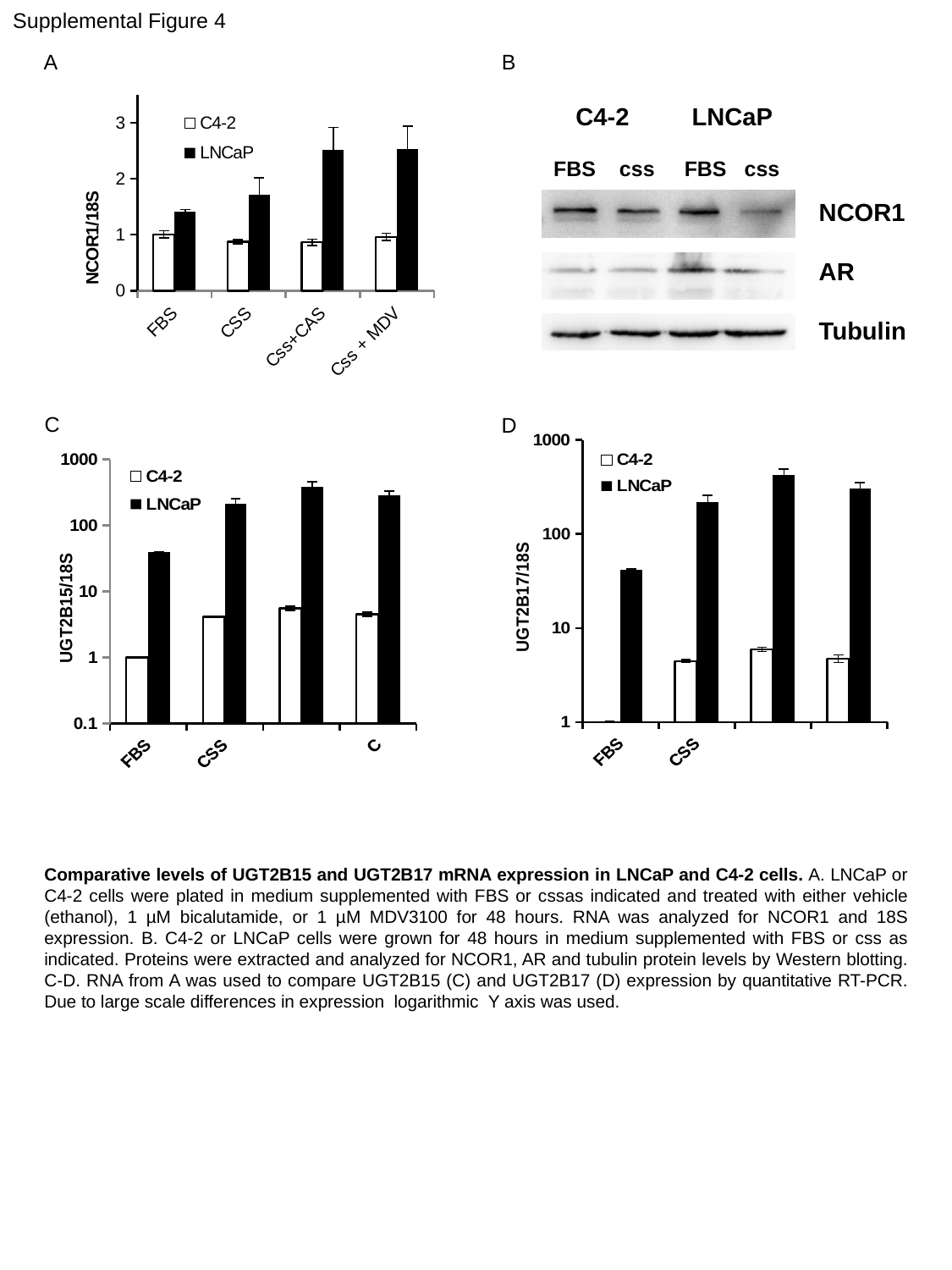
In chart A (NCOR1/18S), how many series does the legend list? 2 In chart A (NCOR1/18S), which category has the lowest LNCaP value? FBS In chart A (NCOR1/18S), is the LNCaP value for FBS greater or less than 1? greater In chart A (NCOR1/18S), which series has the larger value for CSS, C4-2 or LNCaP? LNCaP In chart D (UGT2B17/18S), is the LNCaP value for CSS greater or less than 100? greater In chart D (UGT2B17/18S), which series has the larger value for FBS, C4-2 or LNCaP? LNCaP In chart C (UGT2B15/18S), what is the C4-2 value for FBS? 1 What is the y-axis label of chart C (bottom left)? UGT2B15/18S In chart A (NCOR1/18S), how many categories are shown on the x axis? 4 What kind of chart is chart A (NCOR1/18S)? bar chart In chart C (UGT2B15/18S), is the LNCaP value for FBS greater or less than 100? less